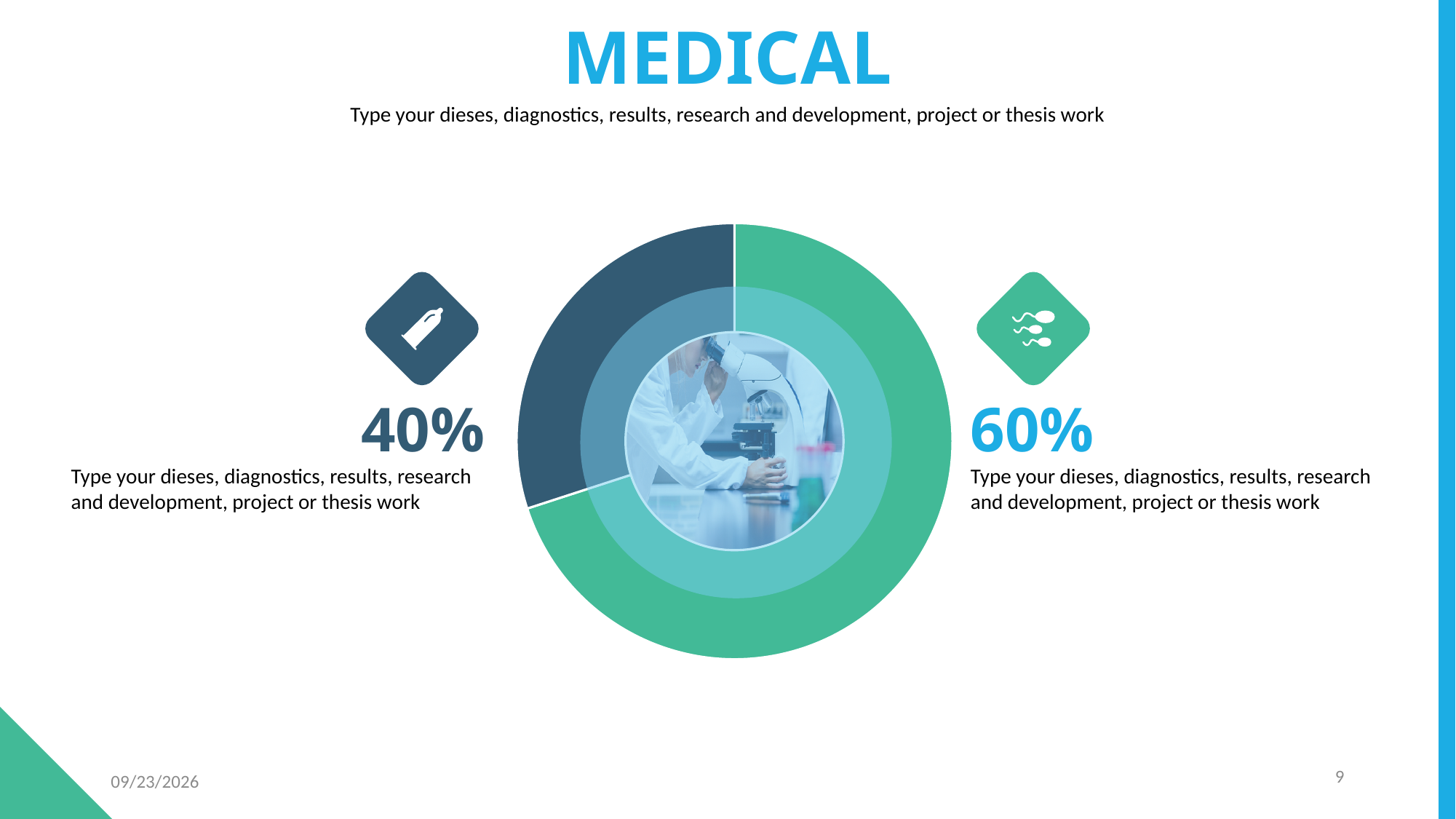
What is the difference between the green segment's share and the dark blue segment's share? 20% Which segment of the donut chart is the smallest? The dark blue segment (40%) Which is larger, the dark blue segment or the green segment? The green segment What is the title of the slide containing the donut chart? MEDICAL What do the two percentages on the donut chart add up to? 100% Which segment of the donut chart is the largest? The green segment (60%) What percentage is shown for the green segment of the donut chart? 60% What kind of chart is shown on the slide? Donut chart How many segments does the donut chart have? 2 What percentage is shown for the dark blue segment of the donut chart? 40% What colour is the segment labelled 60%? Green